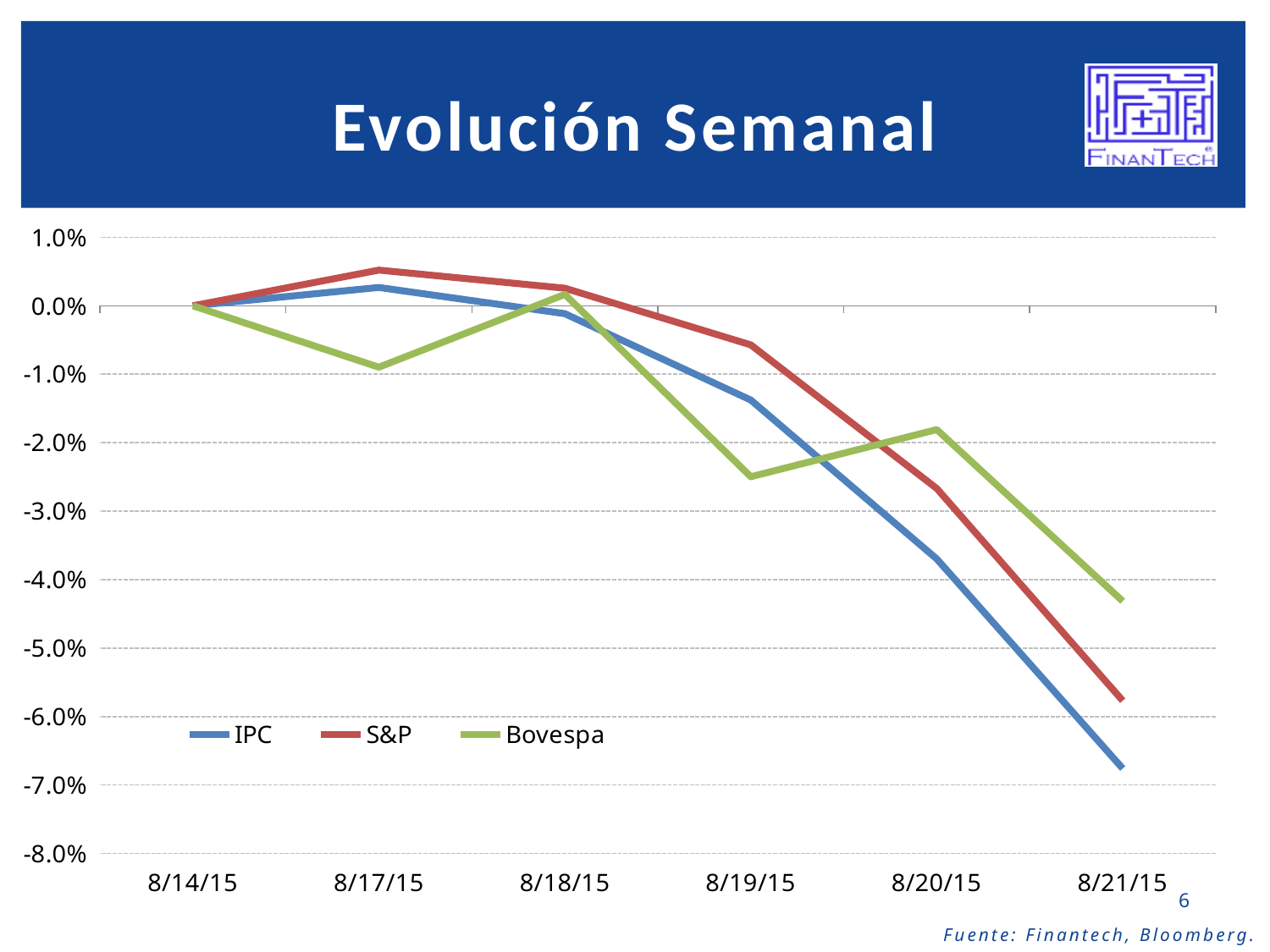
How many dates are shown on the x axis? 6 What is the value of the IPC series on 8/14/15? 0.0% Which series has the lowest value on 8/21/15? IPC On 8/21/15, which is higher, Bovespa or S&P? Bovespa Is the value for Bovespa on 8/19/15 greater or less than -2.0%? less How many series does the legend list? 3 What kind of chart is shown on the slide? Line chart Is the value for S&P on 8/21/15 greater or less than -5.0%? less What is the title of the chart? Evolución Semanal Is the value for IPC on 8/21/15 greater or less than -6.0%? less Does the IPC series rise or fall from 8/18/15 to 8/21/15? Fall